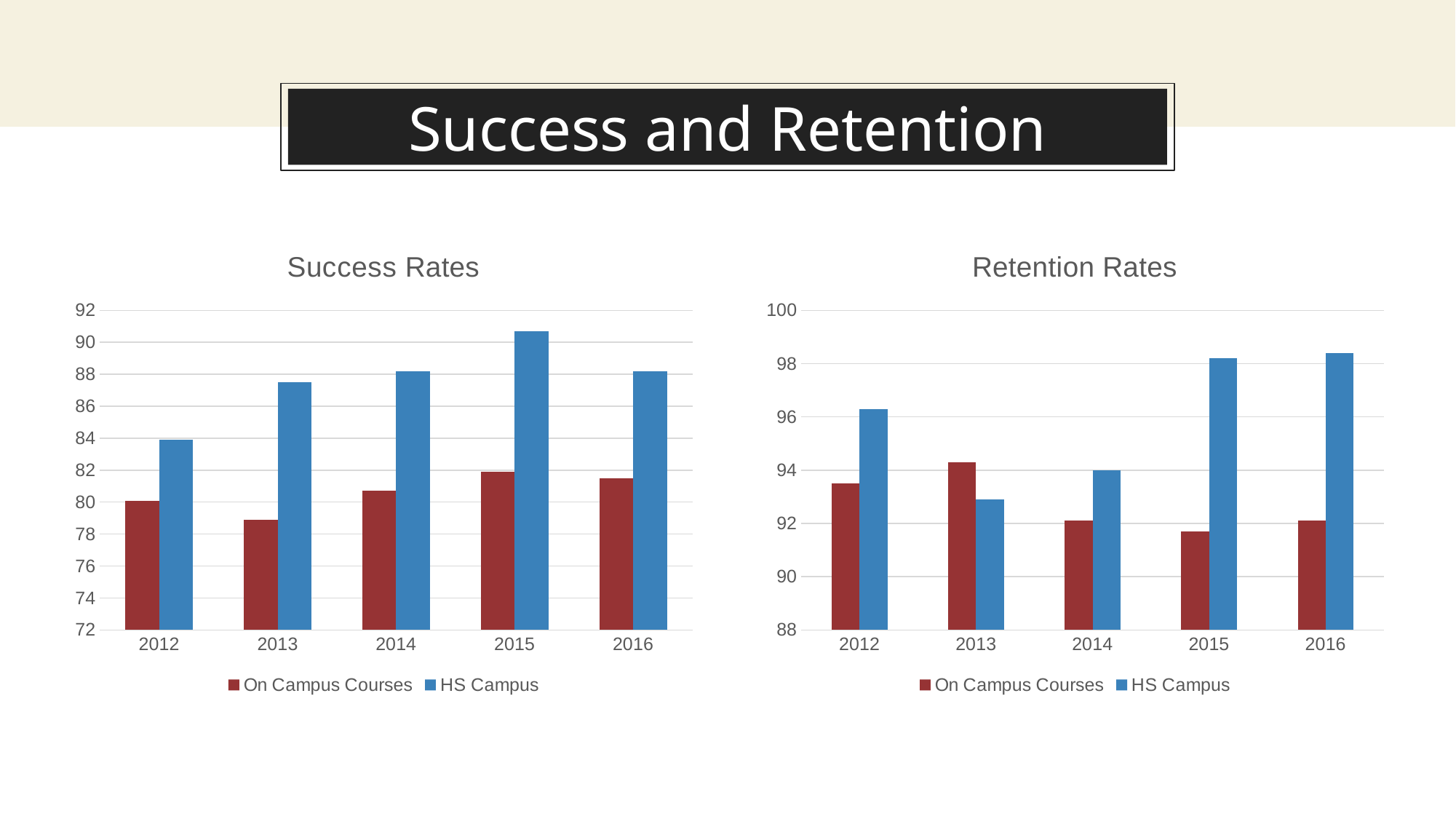
In the Retention Rates chart, which year has the highest On Campus Courses value? 2013 In the Retention Rates chart, which year has the lowest HS Campus value? 2013 In the Success Rates chart, does the HS Campus value rise or fall from 2012 to 2015? rise In the Retention Rates chart, is the On Campus Courses value for 2015 greater or less than 92? less How many years are shown on the x axis of the Success Rates chart? 5 In the Success Rates chart, is the On Campus Courses value for 2013 greater or less than 80? less In the Success Rates chart, is the HS Campus value for 2015 greater or less than 90? greater In the Retention Rates chart, which series has the larger value in 2013, On Campus Courses or HS Campus? On Campus Courses How many series does the legend of the Retention Rates chart list? 2 What kind of chart is the Success Rates chart? bar chart In the Success Rates chart, which year has the lowest On Campus Courses value? 2013 In the Success Rates chart, which year has the highest HS Campus value? 2015